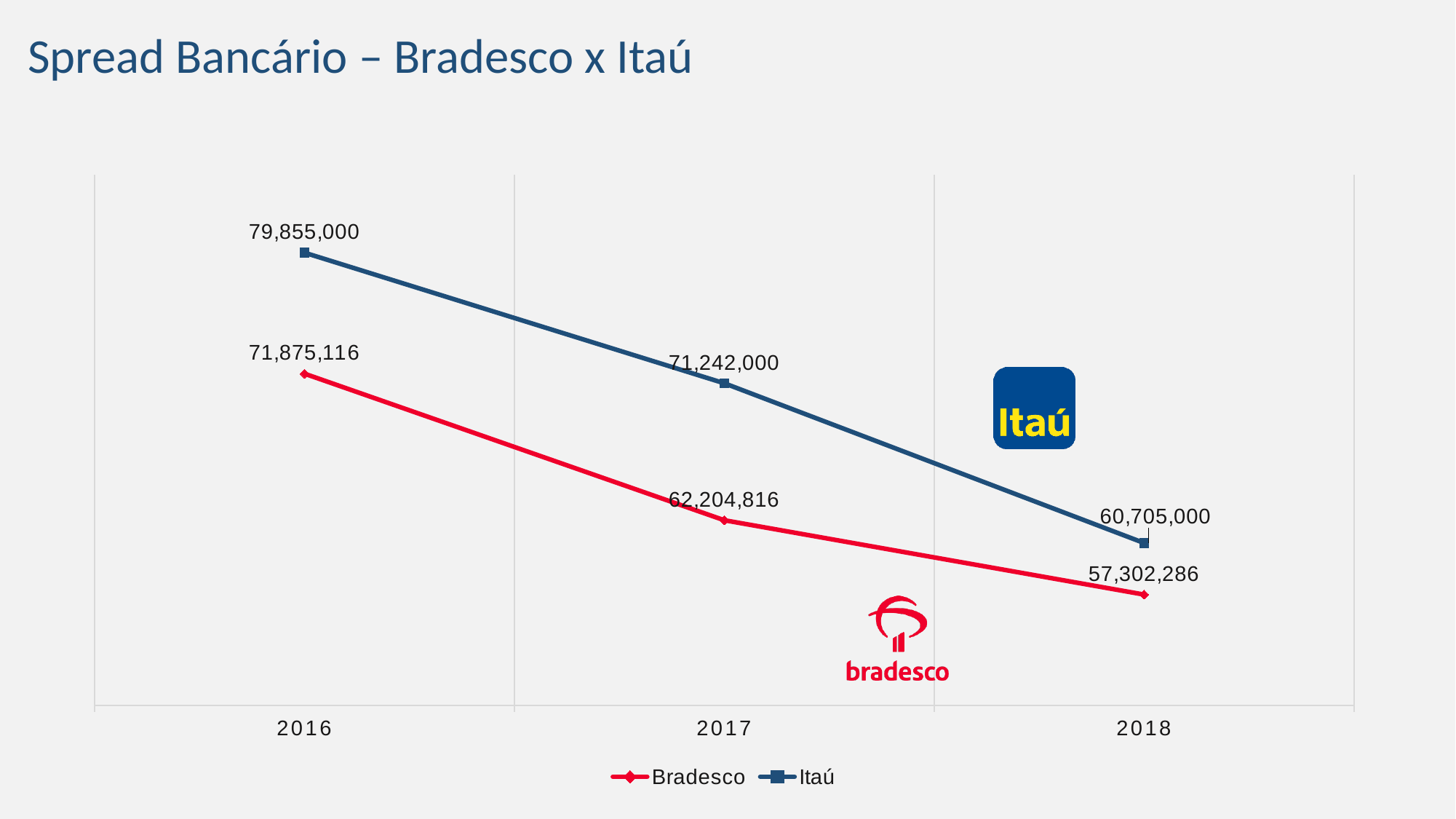
Which series has the larger value in 2018, Bradesco or Itaú? Itaú What is the value for Itaú in 2017? 71,242,000 What is the value for Bradesco in 2017? 62,204,816 By how much did the Itaú value fall from 2016 to 2018? 19,150,000 In which year is the Itaú value highest? 2016 In which year is the Bradesco value lowest? 2018 What is the value for Itaú in 2018? 60,705,000 What is the difference between the Itaú and Bradesco values in 2016? 7,979,884 What is the value for Bradesco in 2016? 71,875,116 How many series does the legend list? 2 What kind of chart is shown on the slide? Line chart How many years are shown on the x axis? 3